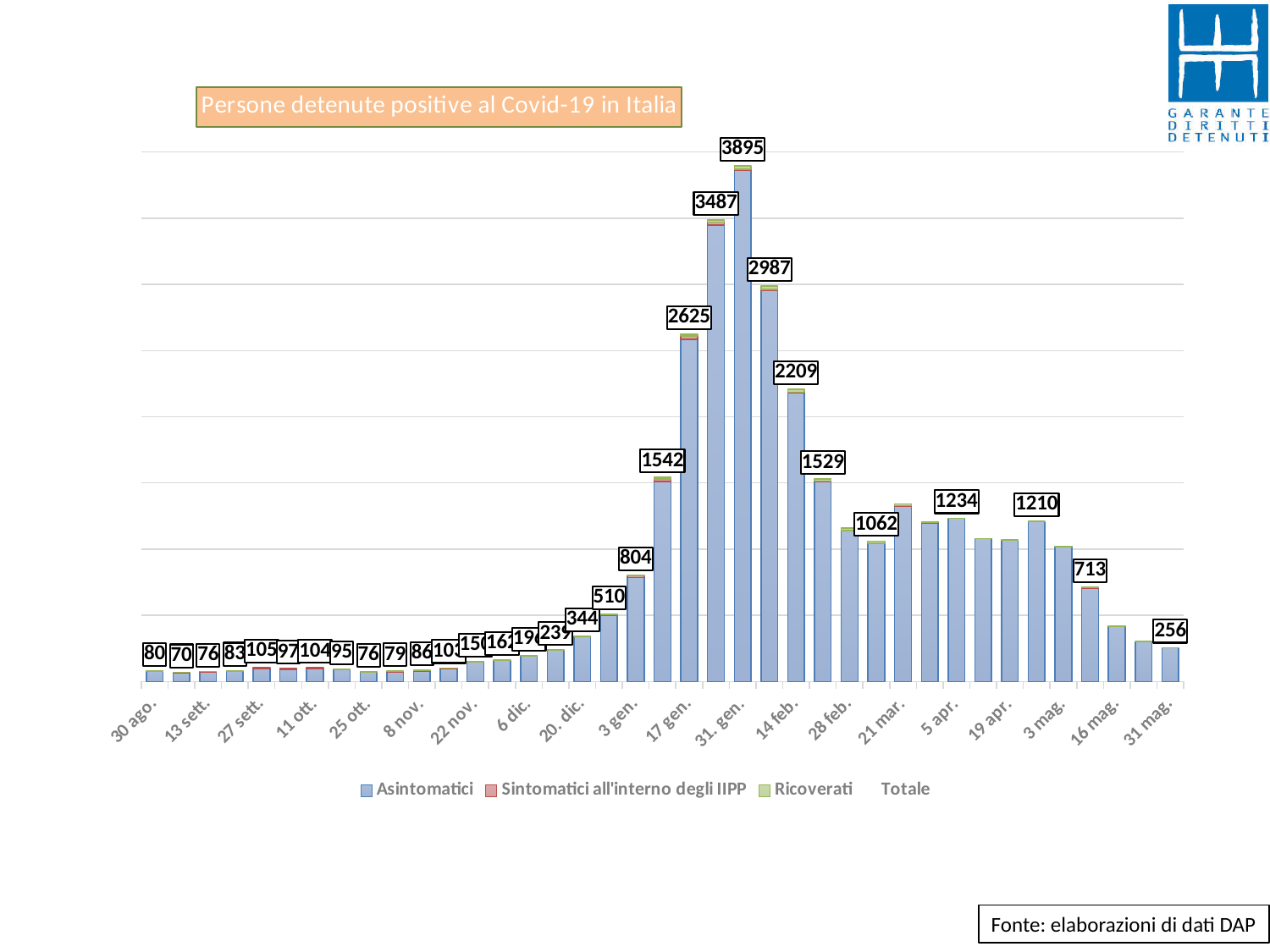
What source is cited for the data on the slide? Fonte: elaborazioni di dati DAP What is the highest total value labelled on the chart? 3895 Which labelled value is larger, 1234 or 1210? 1234 How many series does the legend list? 4 What is the total value labelled on the first bar (30 ago.)? 80 What is the title of the chart? Persone detenute positive al Covid-19 in Italia What type of chart is shown on the slide? bar chart What is the lowest total value labelled on the chart? 70 What is the difference between the peak value 3895 and the preceding labelled value 3487? 408 Which date label appears under the tallest bar? 31. gen. Do the values rise or fall from the peak at 31. gen. to the end of the x axis at 31 mag.? fall What is the total value labelled on the last bar (31 mag.)? 256